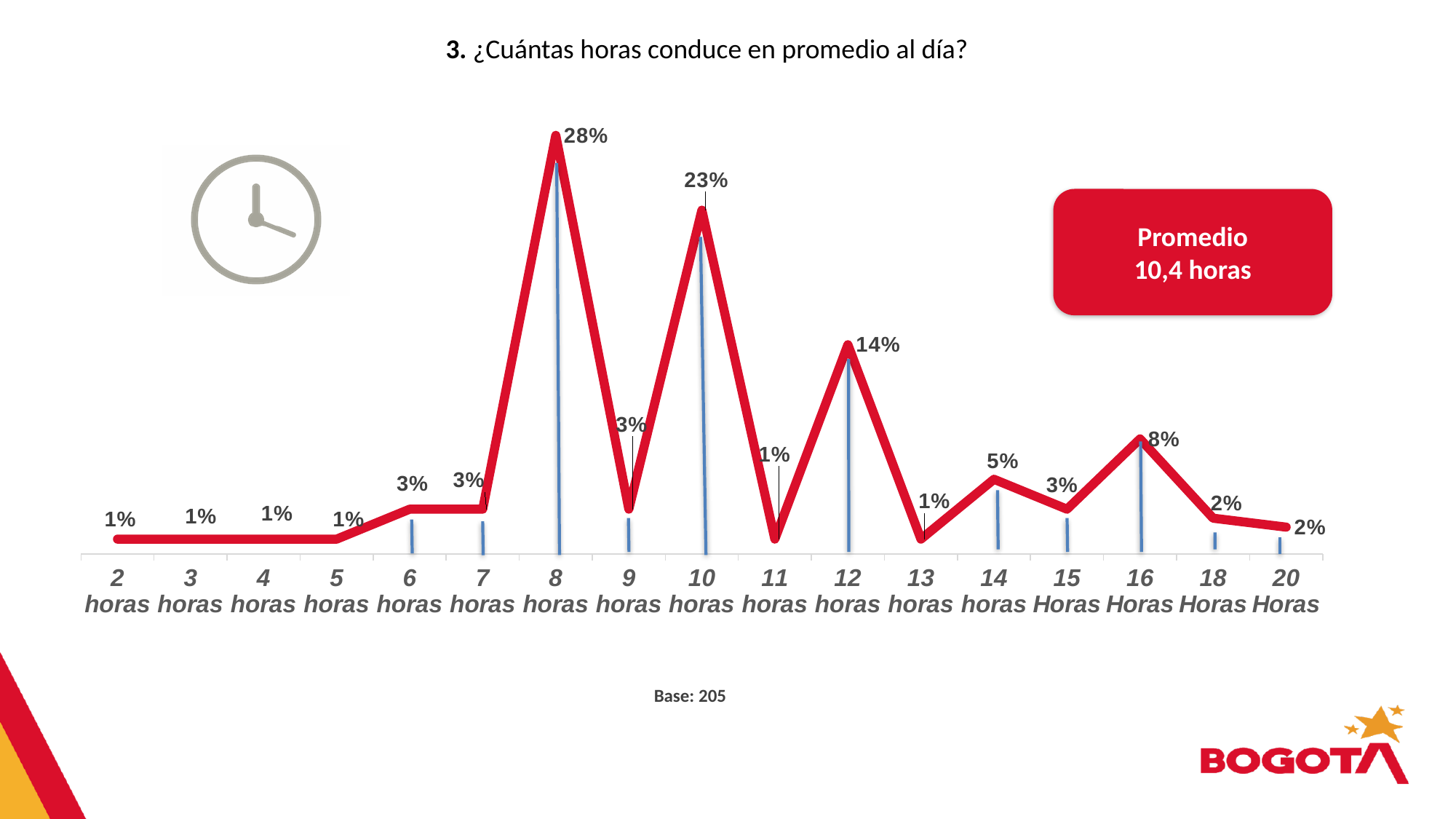
What average number of hours is stated in the red box on the slide? 10,4 horas What is the value for 16 Horas? 8% What percentage is shown for 12 horas? 14% What is the difference between the values for 16 Horas and 18 Horas? 6% Which category has the highest value? 8 horas What is the value shown for 10 horas? 23% What is the base (number of respondents) shown below the chart? 205 What kind of chart is this? Line chart What percentage of respondents drive 8 hours per day on average? 28% What is the difference between the values for 8 horas and 10 horas? 5% How many categories are shown on the x axis? 17 Which is larger, the value for 12 horas or the value for 14 horas? 12 horas